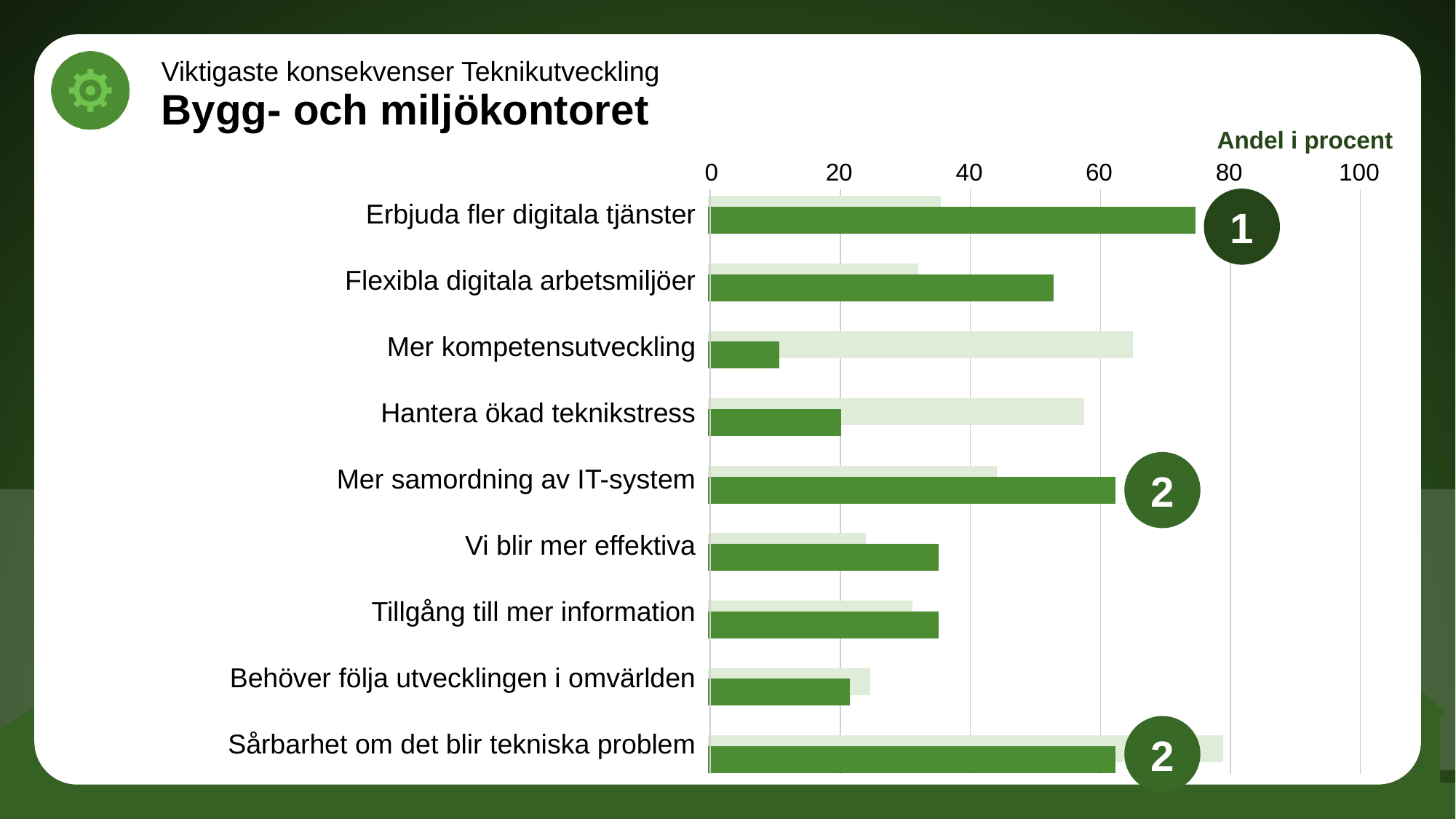
For Hantera ökad teknikstress, which bar is longer: the light green bar or the dark green bar? the light green bar What is the highest tick value shown on the horizontal axis? 100 How many categories are listed on the vertical axis of the chart? 9 Which has the larger dark green bar: Flexibla digitala arbetsmiljöer or Hantera ökad teknikstress? Flexibla digitala arbetsmiljöer What kind of chart is shown on the slide? bar chart Which category has the longest light green bar? Sårbarhet om det blir tekniska problem Which category has the shortest dark green bar? Mer kompetensutveckling Which category has the longest dark green bar? Erbjuda fler digitala tjänster What label is shown above the horizontal axis of the chart? Andel i procent Is the dark green value for Erbjuda fler digitala tjänster greater or less than 60? greater Is the light green value for Mer kompetensutveckling greater or less than 60? greater Is the dark green value for Mer kompetensutveckling greater or less than 20? less